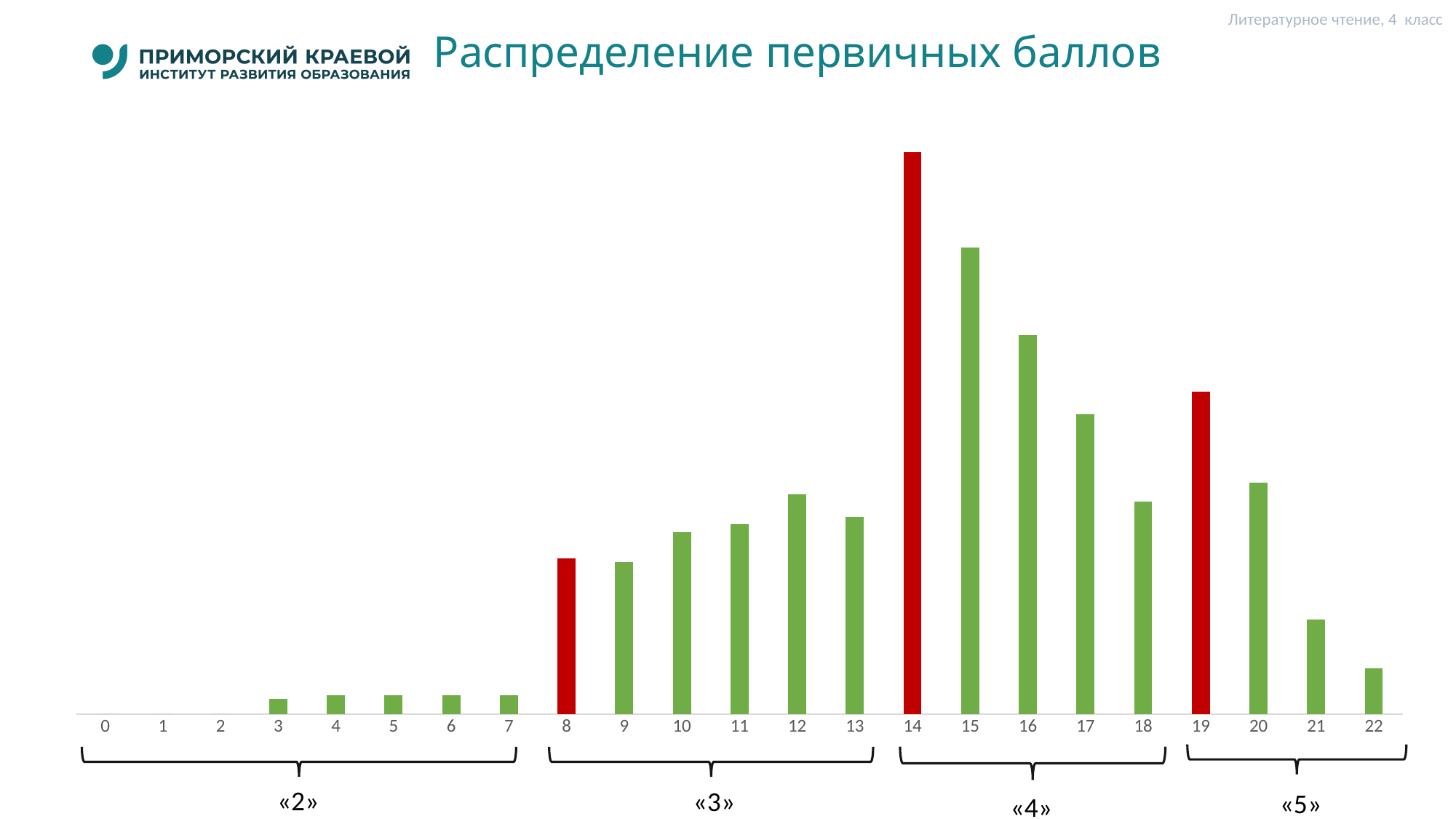
Which scores are shown with red bars? 8, 14, 19 Which scores have no bar at all? 0, 1, 2 Which bar is taller, the one for score 15 or the one for score 16? 15 How many score categories are shown on the x axis? 23 What is the title of the chart? Распределение первичных баллов Which score has the tallest bar? 14 What kind of chart is shown on the slide? bar chart Which score range is grouped under the grade «4» bracket? 14 to 18 Do the bars rise or fall from score 14 to score 18? fall Which bar is taller, the one for score 8 or the one for score 13? 13 Do the bars rise or fall from score 8 to score 12? rise Which bar is taller, the one for score 19 or the one for score 20? 19